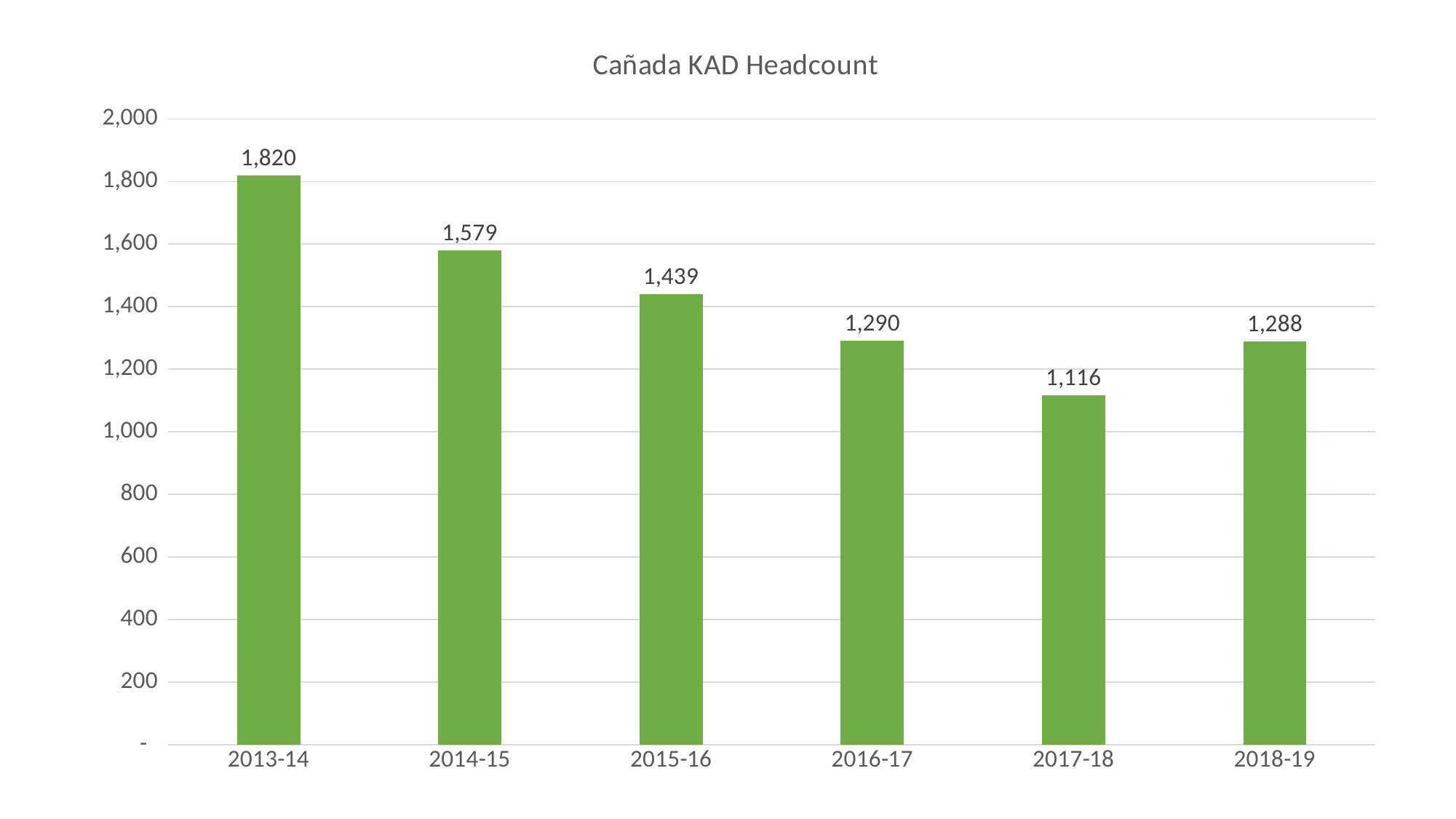
What kind of chart is this? bar chart What is the headcount for 2018-19? 1,288 Is the headcount for 2015-16 greater or less than 1,400? greater What is the difference in headcount between 2018-19 and 2017-18? 172 Which year has the lowest headcount? 2017-18 What is the headcount for 2017-18? 1,116 How many years are shown on the chart? 6 What is the difference in headcount between 2013-14 and 2014-15? 241 Which year has a larger headcount, 2015-16 or 2016-17? 2015-16 Which year has the highest headcount? 2013-14 What is the headcount for 2013-14? 1,820 What is the title of the chart? Cañada KAD Headcount